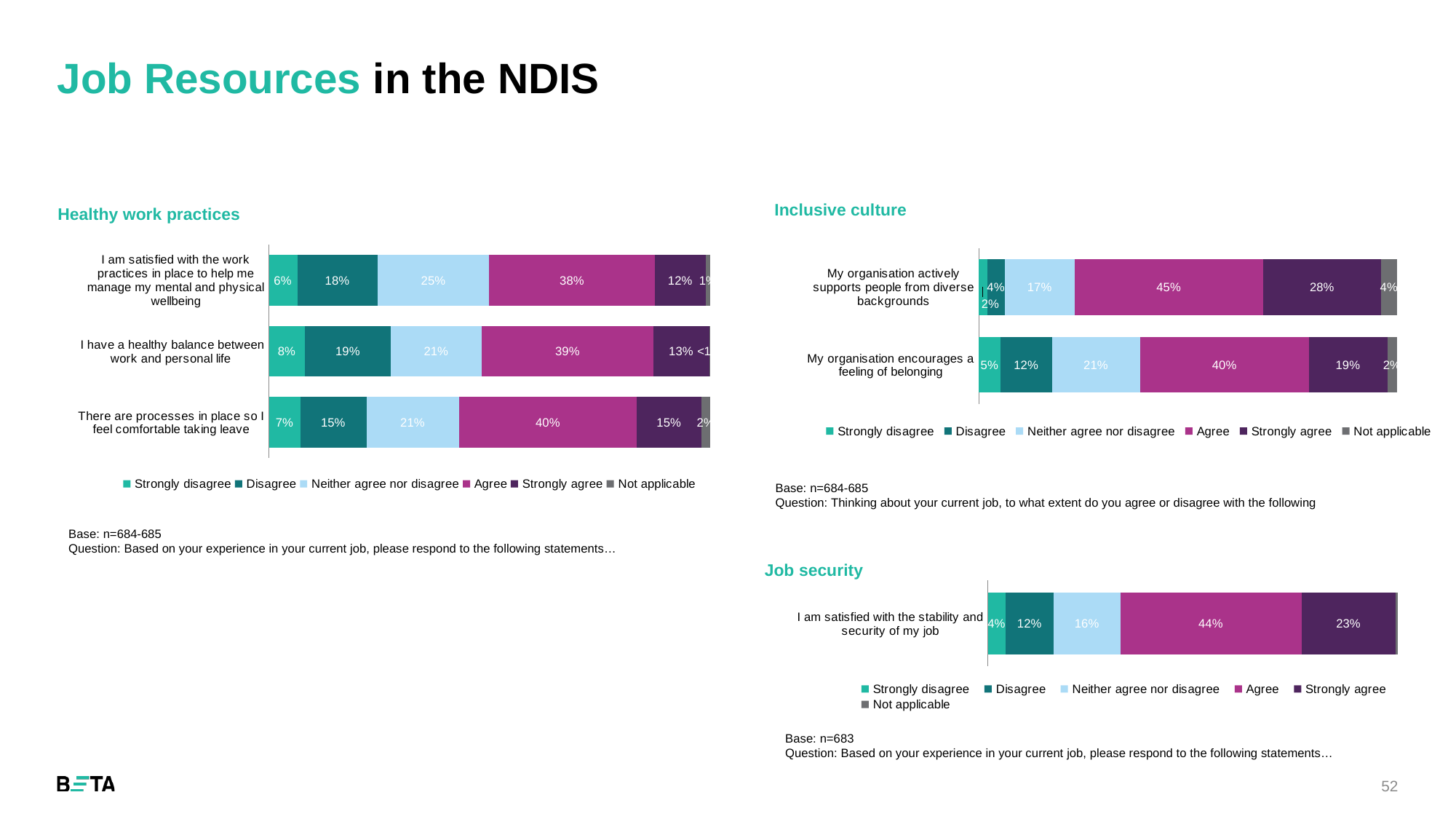
In the Healthy work practices chart, what percentage chose Neither agree nor disagree for "I have a healthy balance between work and personal life"? 21% In the Job security chart, what percentage chose Disagree? 12% In the Healthy work practices chart, how many statements are plotted? 3 In the Inclusive culture chart, which response category has the largest share for "My organisation encourages a feeling of belonging"? Agree In the Inclusive culture chart, what percentage chose Strongly agree for "My organisation actively supports people from diverse backgrounds"? 28% In the Job security chart, what percentage chose Agree for "I am satisfied with the stability and security of my job"? 44% What type of chart is the Job security chart? Stacked bar chart What is the title of the chart at the bottom right of the slide? Job security In the Inclusive culture chart, how many response categories does the legend list? 6 In the Inclusive culture chart, what is the difference in the Agree percentage between "My organisation actively supports people from diverse backgrounds" and "My organisation encourages a feeling of belonging"? 5 percentage points In the Healthy work practices chart, what percentage chose Agree for "There are processes in place so I feel comfortable taking leave"? 40% In the Healthy work practices chart, which statement has the higher Strongly agree percentage: "There are processes in place so I feel comfortable taking leave" or "I am satisfied with the work practices in place to help me manage my mental and physical wellbeing"? There are processes in place so I feel comfortable taking leave